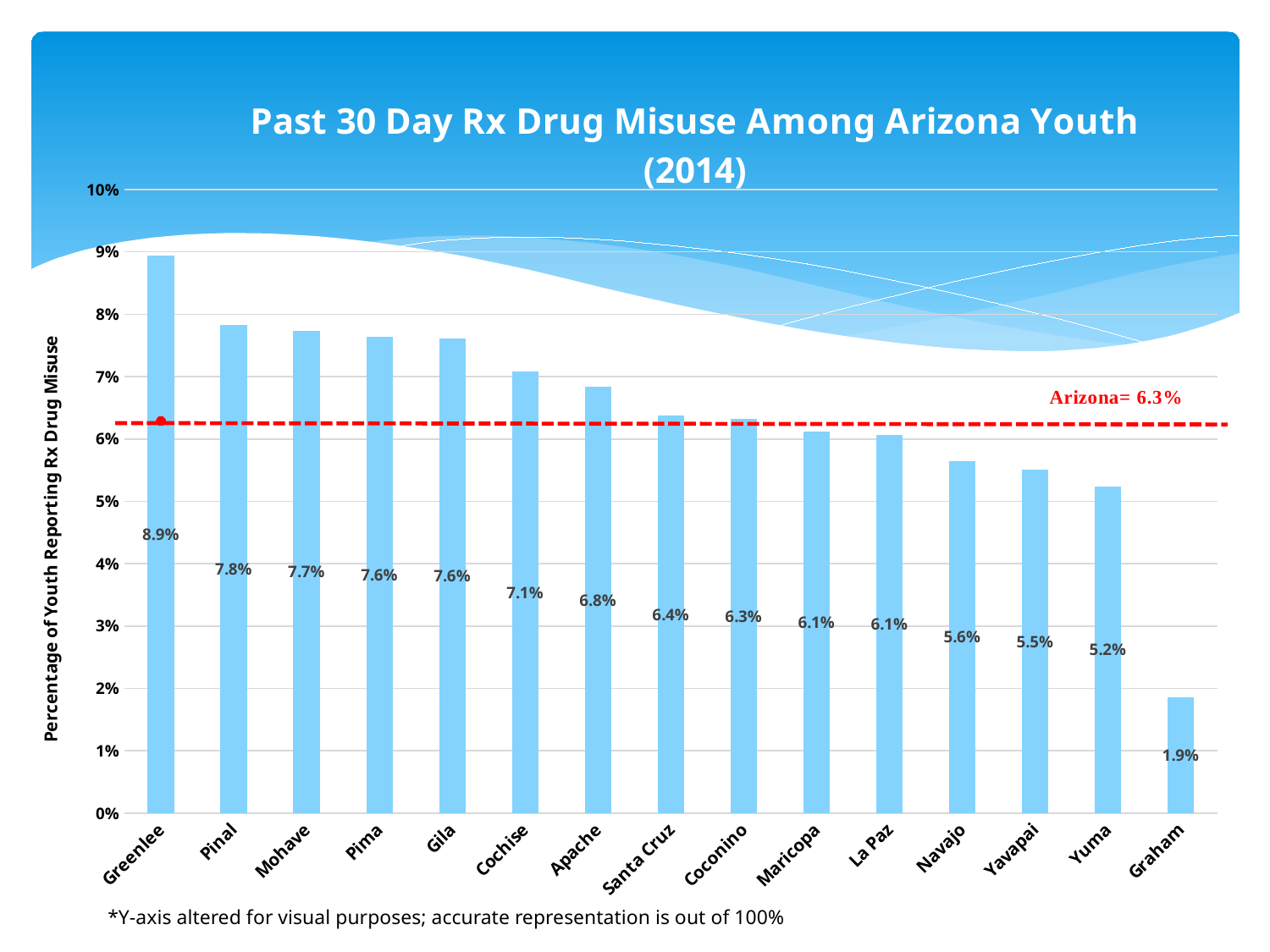
Which is larger, the value for Navajo or the value for Yuma? Navajo Which county has the lowest percentage of youth reporting Rx drug misuse? Graham How many counties are shown on the x axis? 15 Do the values rise or fall from left to right along the x axis? Fall What is the value for Greenlee? 8.9% What is the value for Graham? 1.9% What is the difference between the values for Pinal and Apache? 1.0% What kind of chart is this? Bar chart What is the difference between the values for Greenlee and Graham? 7.0% What is the value for Cochise? 7.1% What Arizona statewide value is marked by the red dashed line? 6.3% Which county has the highest percentage of youth reporting Rx drug misuse? Greenlee